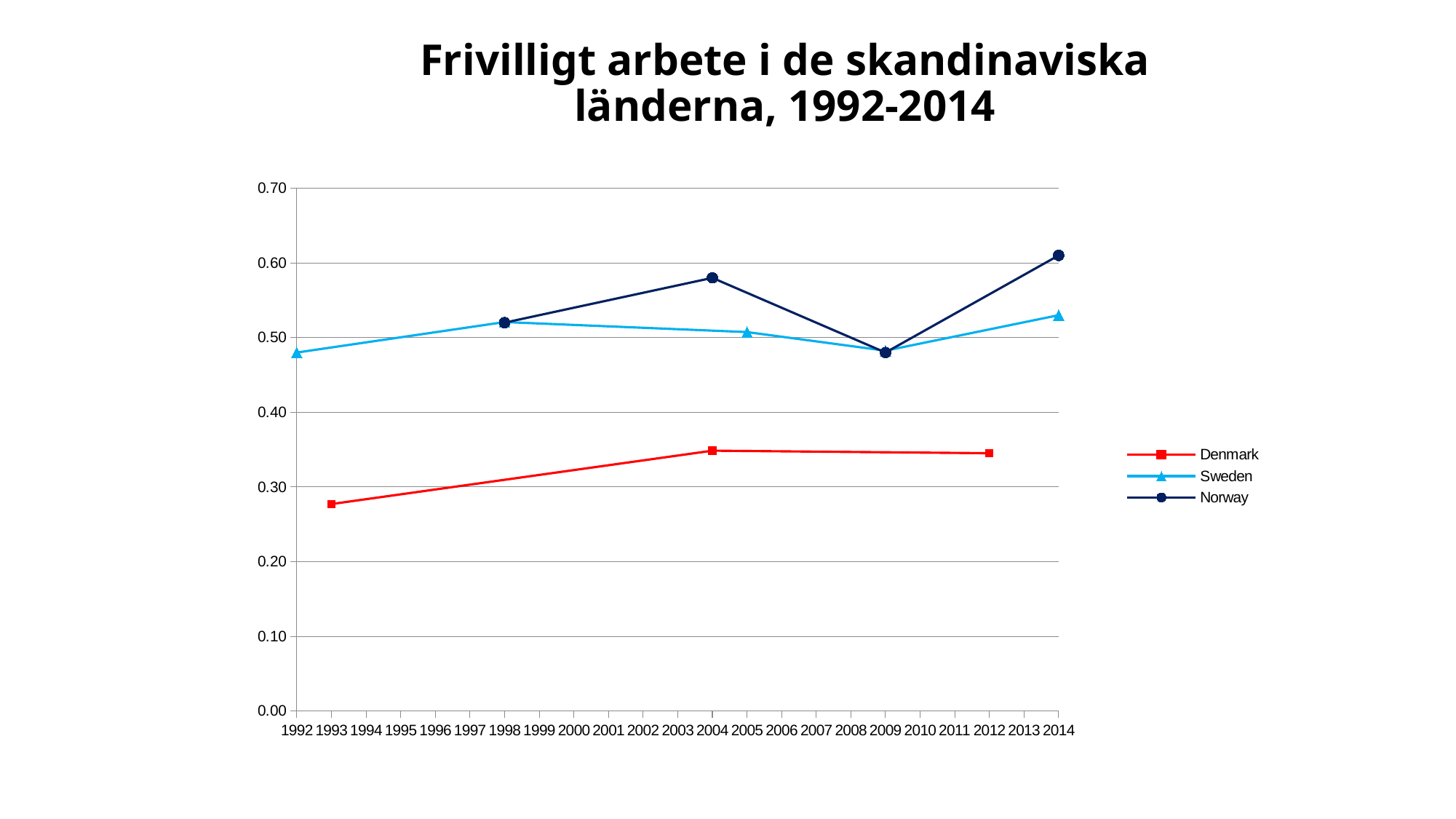
How many data points are plotted for Denmark? 3 Is the value for Denmark in 1993 greater or less than 0.30? less Is the value for Sweden in 1992 greater or less than 0.50? less Which is larger in 2014, the value for Norway or the value for Sweden? Norway Is the value for Denmark in 2004 greater or less than 0.30? greater What kind of chart is shown on the slide? line chart Does the Norway line rise or fall between 2009 and 2014? rise Which series has the lowest plotted value on the chart? Denmark Which series has the highest plotted value on the chart? Norway What is the title of the chart? Frivilligt arbete i de skandinaviska länderna, 1992-2014 How many series does the legend list? 3